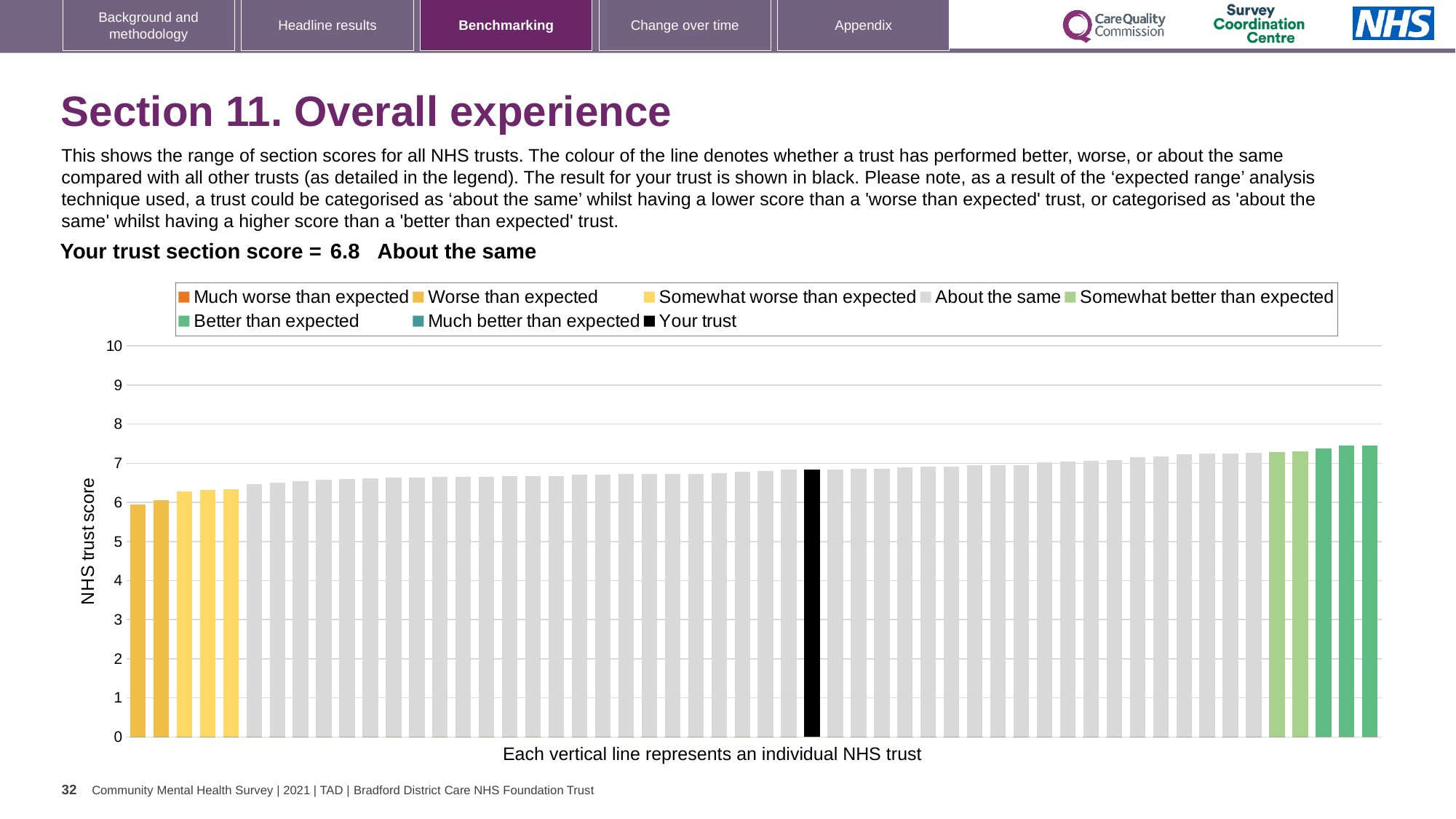
Which legend category does the shortest bar belong to? Worse than expected What kind of chart is shown on the slide? bar chart Is the value of the tallest bar greater or less than 7? greater Is the bar for Your trust taller or shorter than the tallest bar on the chart? shorter Is the value for Your trust greater or less than 5? greater Do the bar values rise or fall from left to right along the x axis? rise What is the label on the vertical axis of the chart? NHS trust score How many entries does the chart legend list? 8 What is the section score for Your trust? 6.8 What colour is the bar representing Your trust? black Which legend category does the tallest bar belong to? Better than expected Is the value of the lowest bar greater or less than 7? less